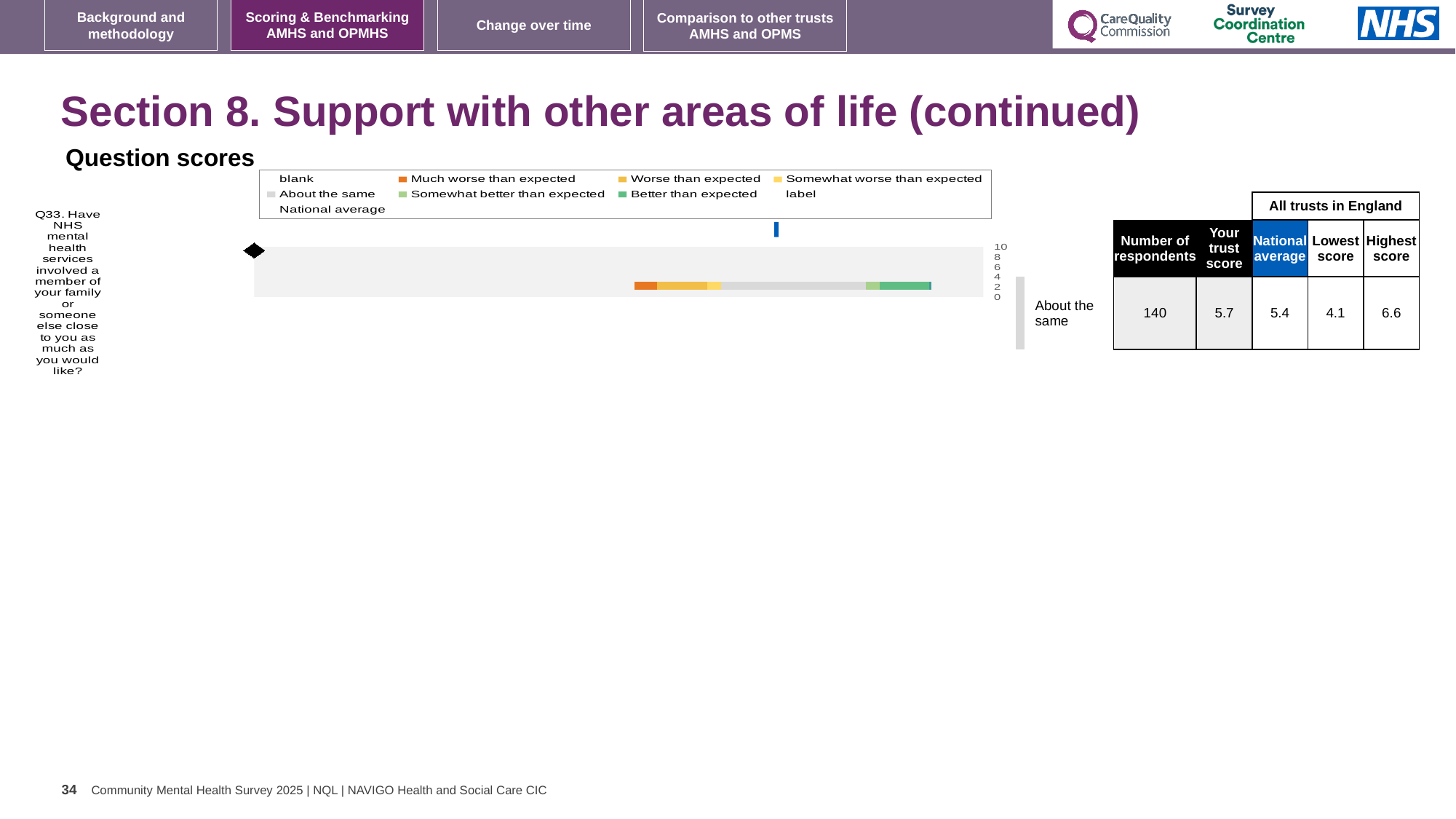
What is the difference between the trust score and the national average for Q33? 0.3 What kind of chart is shown on the slide for Q33? bar chart What is the 'Your trust score' value for Q33 shown on the slide? 5.7 Which is larger for Q33: the trust score or the national average? Your trust score How many questions are plotted in the chart on the slide? 1 What is the highest score among all trusts in England for Q33? 6.6 What is the difference between the highest and lowest scores for Q33 across all trusts in England? 2.5 What rating category is shown next to the chart for Q33? About the same What is the national average score for Q33 shown on the slide? 5.4 How many entries does the chart legend list? 9 What is the lowest score among all trusts in England for Q33? 4.1 How many respondents answered Q33? 140